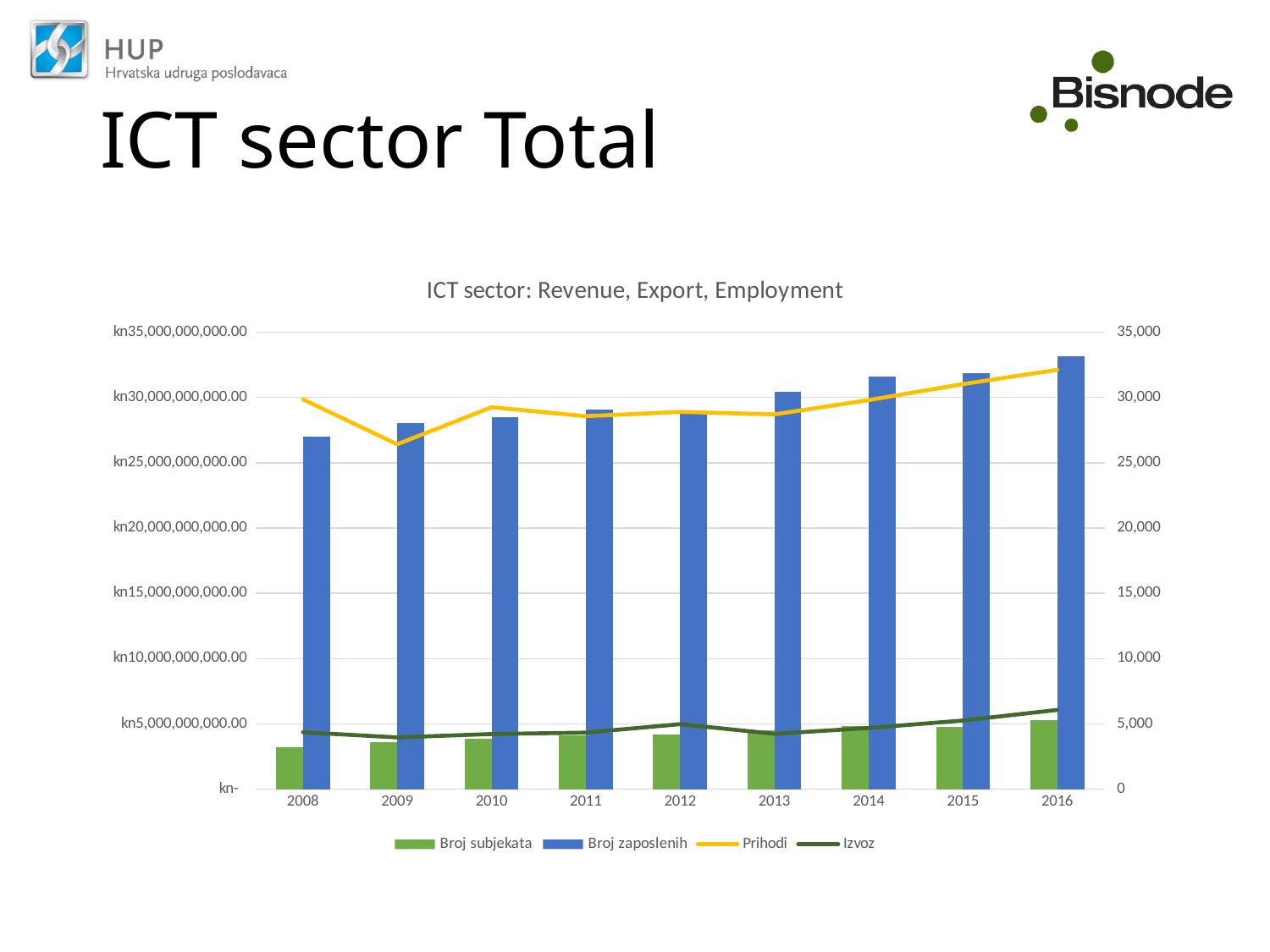
What is the title of the chart? ICT sector: Revenue, Export, Employment Which year has the larger Broj zaposlenih bar, 2013 or 2014? 2014 In which year is the Broj subjekata bar the lowest? 2008 Is the Broj zaposlenih value for 2016 greater or less than 30,000 on the right axis? greater In which year is the Broj zaposlenih bar the lowest? 2008 How many years are shown on the x axis of the chart? 9 In which year is the Broj subjekata bar the highest? 2016 Is the Broj zaposlenih value for 2008 greater or less than 30,000 on the right axis? less In which year does the Prihodi line reach its lowest point? 2009 How many series does the chart legend list? 4 What kind of chart is shown on the slide? A combined bar and line chart In which year is the Broj zaposlenih bar the highest? 2016